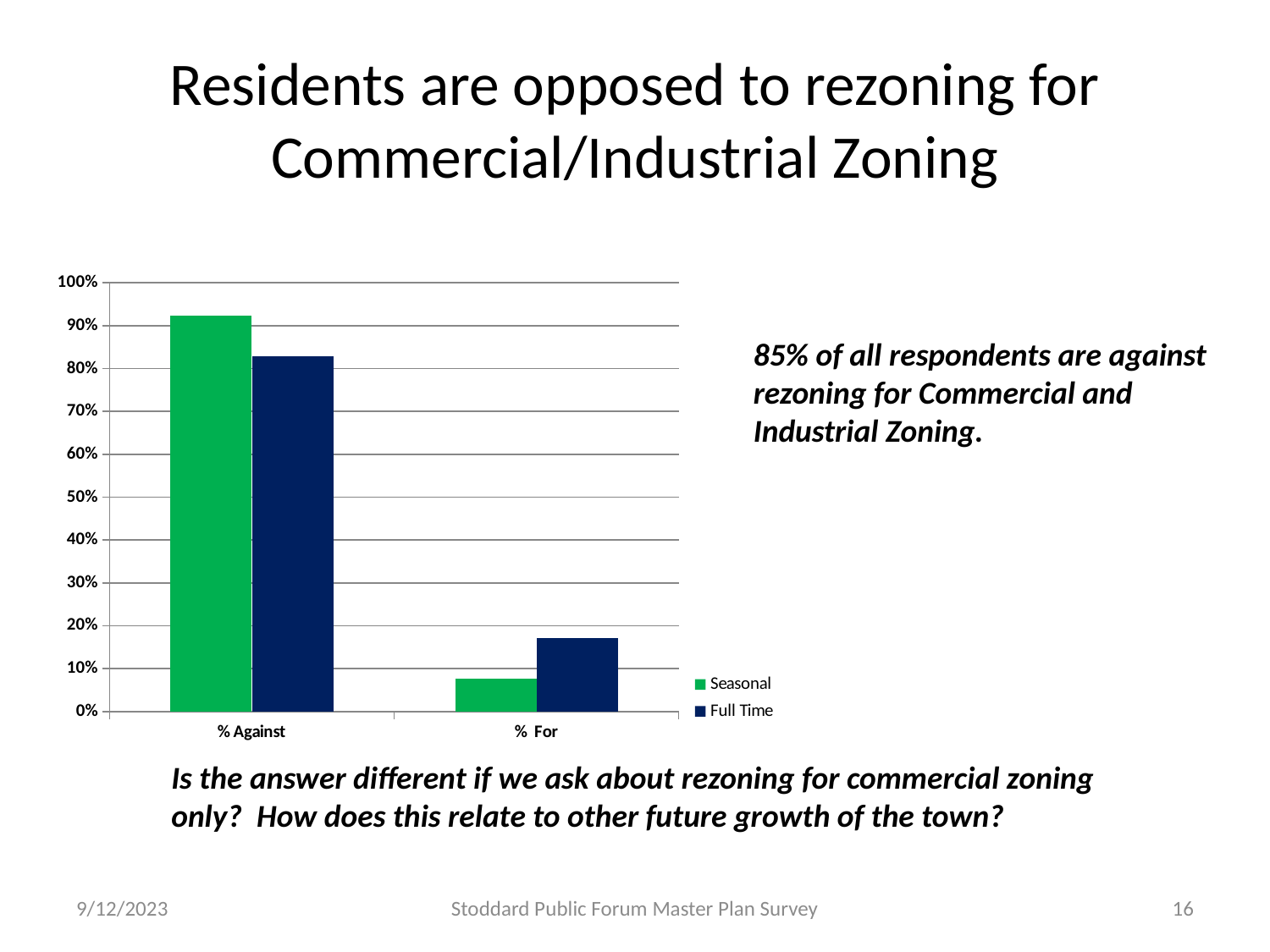
Which category has the lowest bar in the chart? % For (Seasonal) How many categories are shown on the x axis of the chart? 2 What kind of chart is shown on the slide? bar chart Which series has the higher value for % Against, Seasonal or Full Time? Seasonal How many series does the chart legend list? 2 Is the Seasonal value for % For greater or less than 10%? less Which category has the highest bar in the chart? % Against (Seasonal) Is the Full Time value for % Against greater or less than 90%? less What colour represents the Full Time series in the chart? dark blue Is the Seasonal value for % Against greater or less than 90%? greater Which series has the higher value for % For, Seasonal or Full Time? Full Time